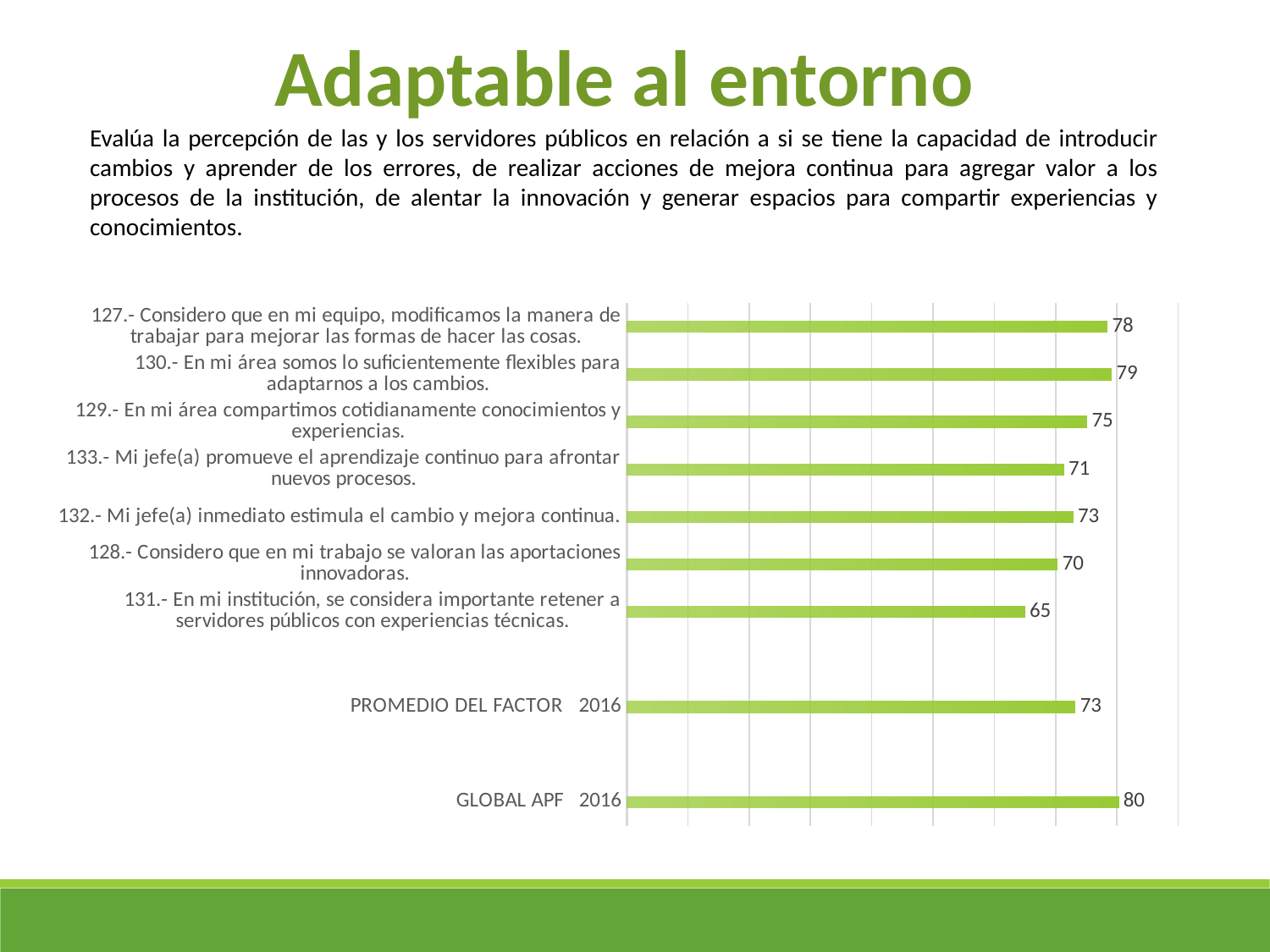
What is the difference between the values for item 130 and item 131? 14 What kind of chart is shown on the slide? Bar chart What is the difference between the value for GLOBAL APF 2016 and the value for PROMEDIO DEL FACTOR 2016? 7 Which category has the highest value in the chart? GLOBAL APF 2016 Which category has the lowest value in the chart? 131.- En mi institución, se considera importante retener a servidores públicos con experiencias técnicas. What value is shown for item 127 ("Considero que en mi equipo, modificamos la manera de trabajar para mejorar las formas de hacer las cosas")? 78 How many bars are plotted in the chart? 9 What is the title of the slide containing the chart? Adaptable al entorno What value is shown for PROMEDIO DEL FACTOR 2016? 73 Which has a larger value, item 129 or item 133? 129.- En mi área compartimos cotidianamente conocimientos y experiencias. What value is shown for GLOBAL APF 2016? 80 What value is shown for item 131 ("En mi institución, se considera importante retener a servidores públicos con experiencias técnicas")? 65